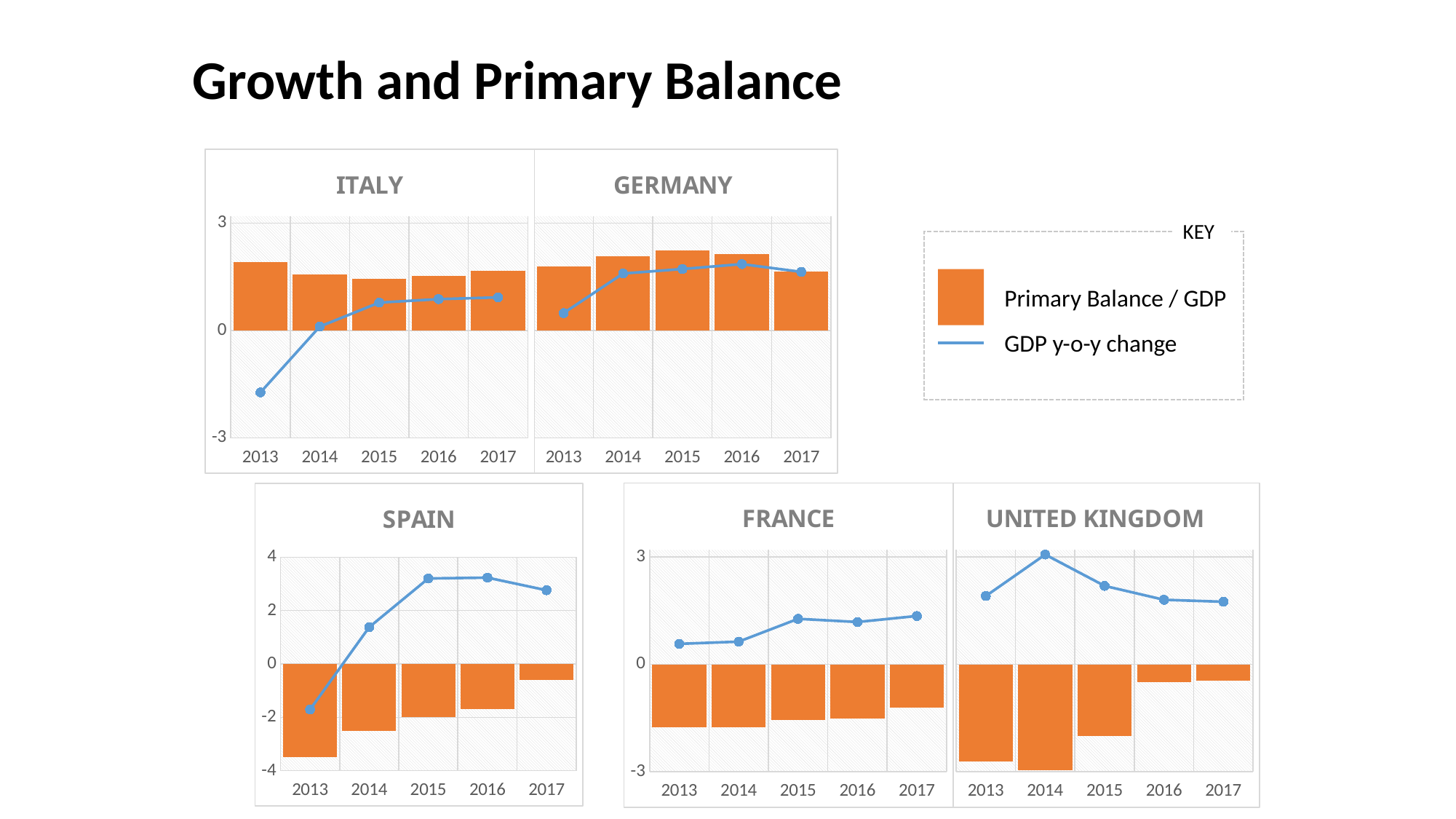
In the ITALY chart, how many years are plotted on the x axis? 5 In the SPAIN chart, which year has the lowest Primary Balance / GDP bar? 2013 In the ITALY chart, does the GDP y-o-y change line rise or fall from 2013 to 2017? Rises What kind of chart is used in each country panel on the slide? A combined bar and line chart In the UNITED KINGDOM chart, which year has the lowest Primary Balance / GDP bar? 2014 In the FRANCE chart, is the Primary Balance / GDP bar for 2017 higher or lower than the bar for 2013? Higher In the ITALY chart, is the GDP y-o-y change for 2013 greater or less than 0? less How many series does the key list? 2 In the GERMANY chart, is the Primary Balance / GDP for 2013 greater or less than 0? greater In the SPAIN chart, is the GDP y-o-y change for 2015 greater or less than 2? greater In the UNITED KINGDOM chart, which year has the highest GDP y-o-y change? 2014 In the SPAIN chart, does the Primary Balance / GDP rise or fall from 2013 to 2017? Rises